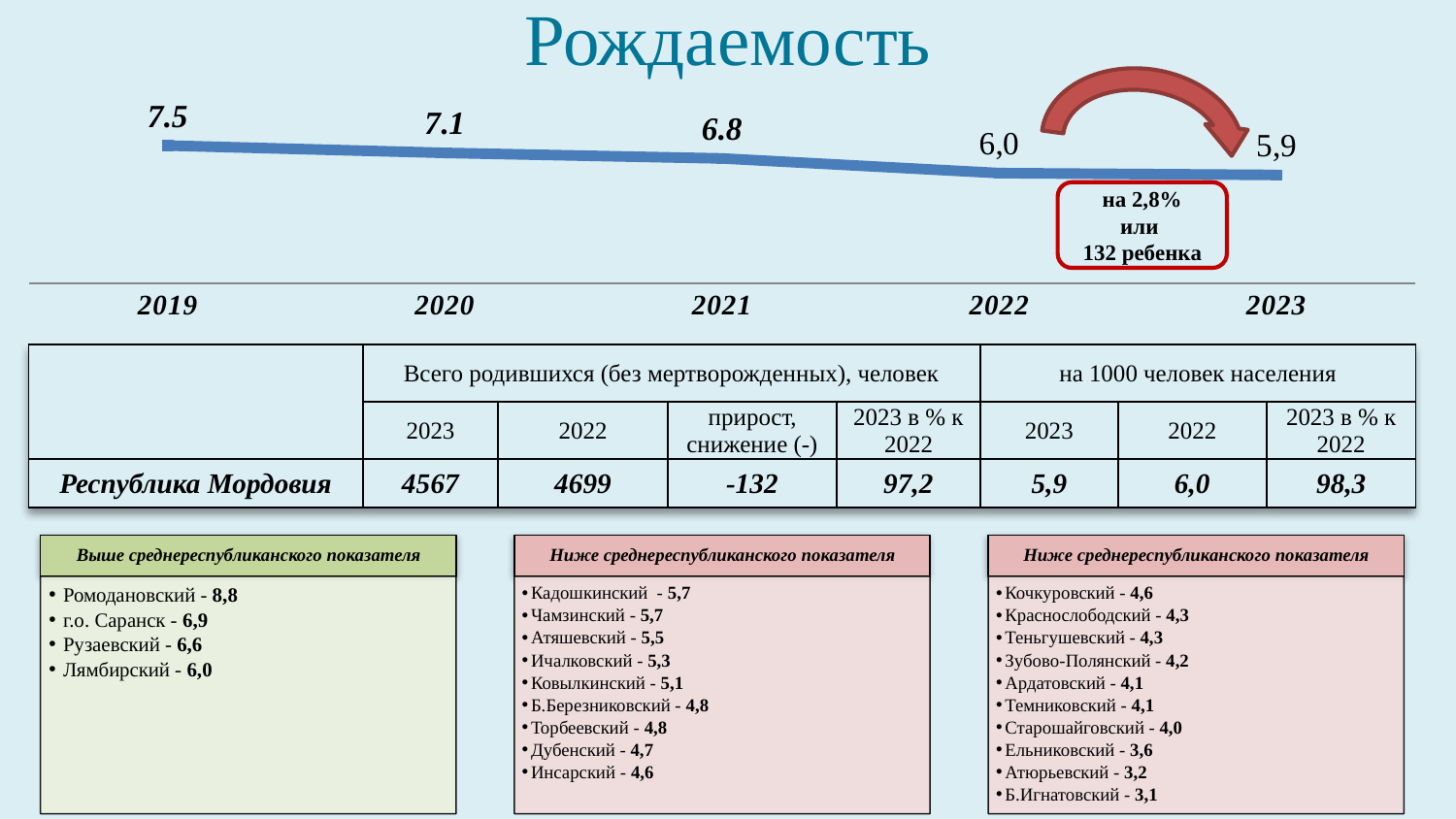
What is the birth rate value shown for 2021 on the line chart? 6.8 What is the title of the chart on the slide? Рождаемость What is the birth rate value shown for 2020 on the line chart? 7.1 What is the birth rate value shown for 2023 on the line chart? 5,9 Do the values on the line chart rise or fall from 2019 to 2023? fall Which year has the lowest value on the line chart? 2023 What is the difference between the 2019 value and the 2020 value on the line chart? 0.4 What is the birth rate value shown for 2019 on the line chart? 7.5 Which is larger on the line chart, the value for 2021 or the value for 2022? 2021 Which year has the highest value on the line chart? 2019 How many years (data points) are plotted on the line chart? 5 What type of chart is used to show the birth rate over the years? line chart